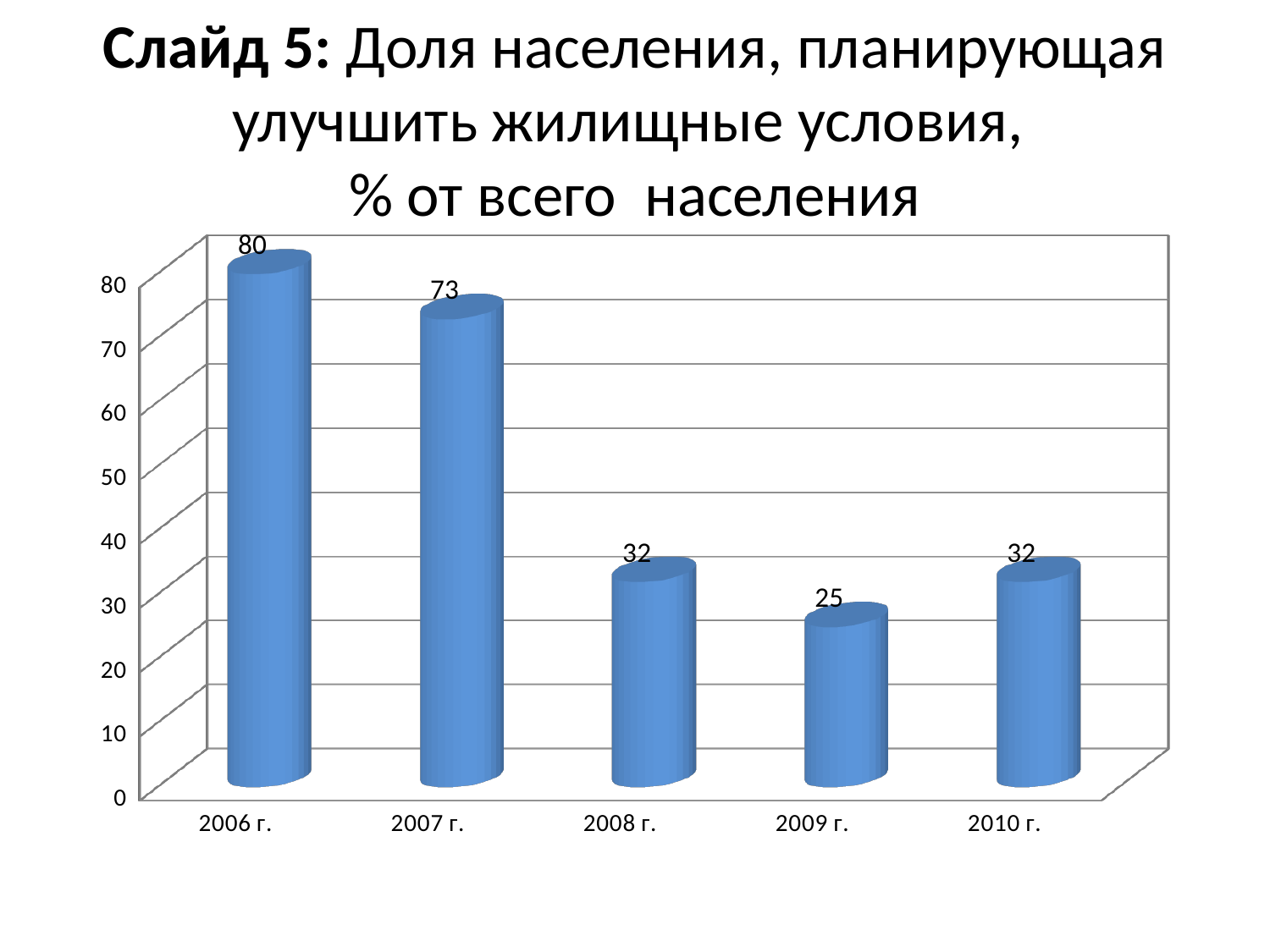
Is the value for 2009 г. greater or less than 30? less What is the value for 2009 г.? 25 What is the difference between the values for 2008 г. and 2009 г.? 7 What is the value for 2007 г.? 73 Which year has the highest value? 2006 г. What is the difference between the values for 2006 г. and 2007 г.? 7 Which year has the lowest value? 2009 г. Do the values generally rise or fall from 2006 г. to 2009 г.? fall What is the value for 2006 г.? 80 Which is larger, the value for 2007 г. or the value for 2010 г.? 2007 г. How many years are shown on the x axis? 5 What kind of chart is shown on the slide? bar chart